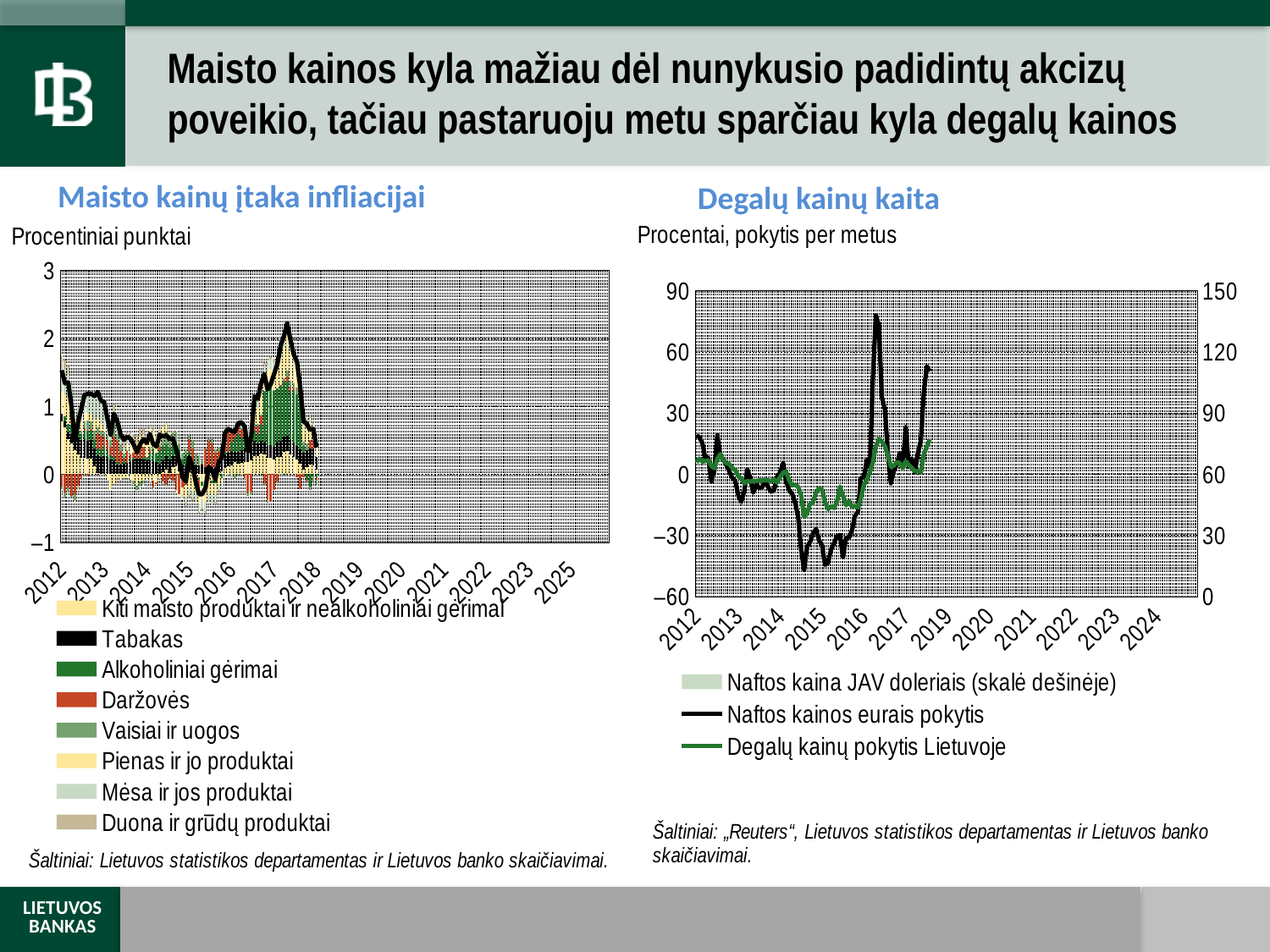
In the left chart "Maisto kainų įtaka infliacijai", is the peak of the black line around 2017 greater or less than 2? greater How many series does the legend of the right chart "Degalų kainų kaita" list? 3 In the right chart "Degalų kainų kaita", is the peak of the black line "Naftos kainos eurais pokytis" around 2016 greater or less than 60? greater What kind of chart is the left chart titled "Maisto kainų įtaka infliacijai"? Stacked bar chart with a line In the right chart "Degalų kainų kaita", is the lowest point of the black line "Naftos kainos eurais pokytis" around 2015 greater or less than -30? less What kind of chart is the right chart titled "Degalų kainų kaita"? Combination bar and line chart In the right chart "Degalų kainų kaita", which legend entry is plotted on the right-hand scale? Naftos kaina JAV doleriais (skalė dešinėje) In the left chart "Maisto kainų įtaka infliacijai", what is the lowest value shown on the vertical axis? –1 In the left chart "Maisto kainų įtaka infliacijai", what unit is given below the title? Procentiniai punktai How many series does the legend of the left chart "Maisto kainų įtaka infliacijai" list? 8